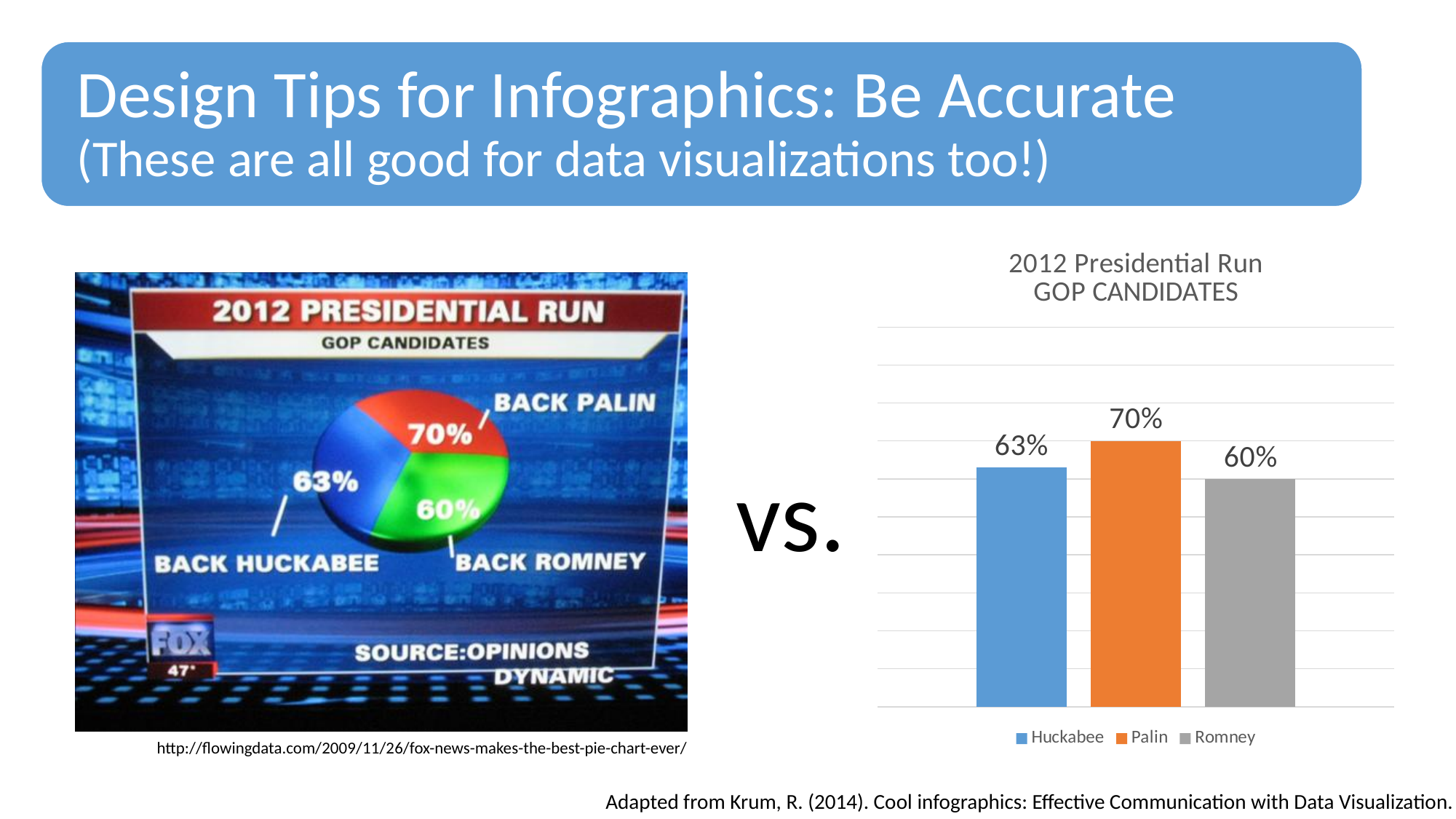
What kind of chart is shown in the Fox News image on the left side of the slide? Pie chart How many series does the legend of the bar chart on the right list? 3 In the pie chart on the left, what percentage is shown for the Back Palin slice? 70% In the bar chart on the right, what is the difference between the values for Palin and Romney? 10% In the bar chart on the right, what is the value for Palin? 70% In the bar chart on the right, what is the value for Huckabee? 63% In the bar chart on the right, which candidate has the lowest value? Romney In the bar chart on the right, what is the value for Romney? 60% In the bar chart on the right, which is larger, the value for Huckabee or the value for Romney? Huckabee In the bar chart on the right, what colour is the bar for Palin? Orange In the bar chart on the right, which candidate has the highest value? Palin What kind of chart is shown on the right side of the slide? Bar chart